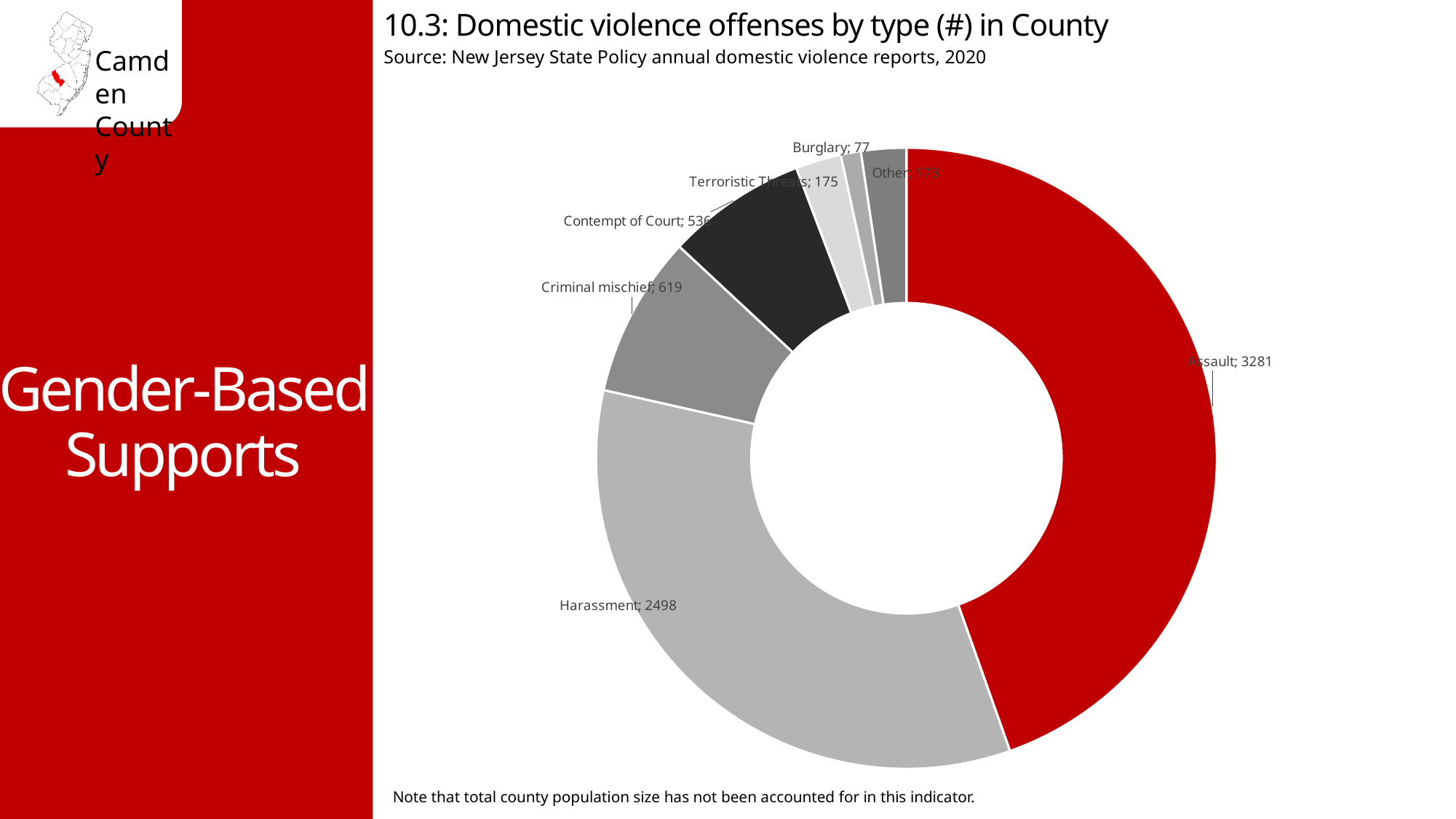
What is the value for Criminal mischief? 619 What kind of chart is shown on the slide? Pie (donut) chart What is the value for Harassment? 2498 How many domestic violence offenses of type Assault are shown? 3281 What is the value for Contempt of Court? 536 What is the source cited for the chart? New Jersey State Policy annual domestic violence reports, 2020 How many offense types (slices) are shown in the chart? 7 Which offense type has the lowest number of offenses? Burglary What is the difference between the Assault and Harassment values? 783 Which is larger, Criminal mischief or Contempt of Court? Criminal mischief What is the value for Terroristic Threats? 175 Which offense type has the highest number of offenses? Assault